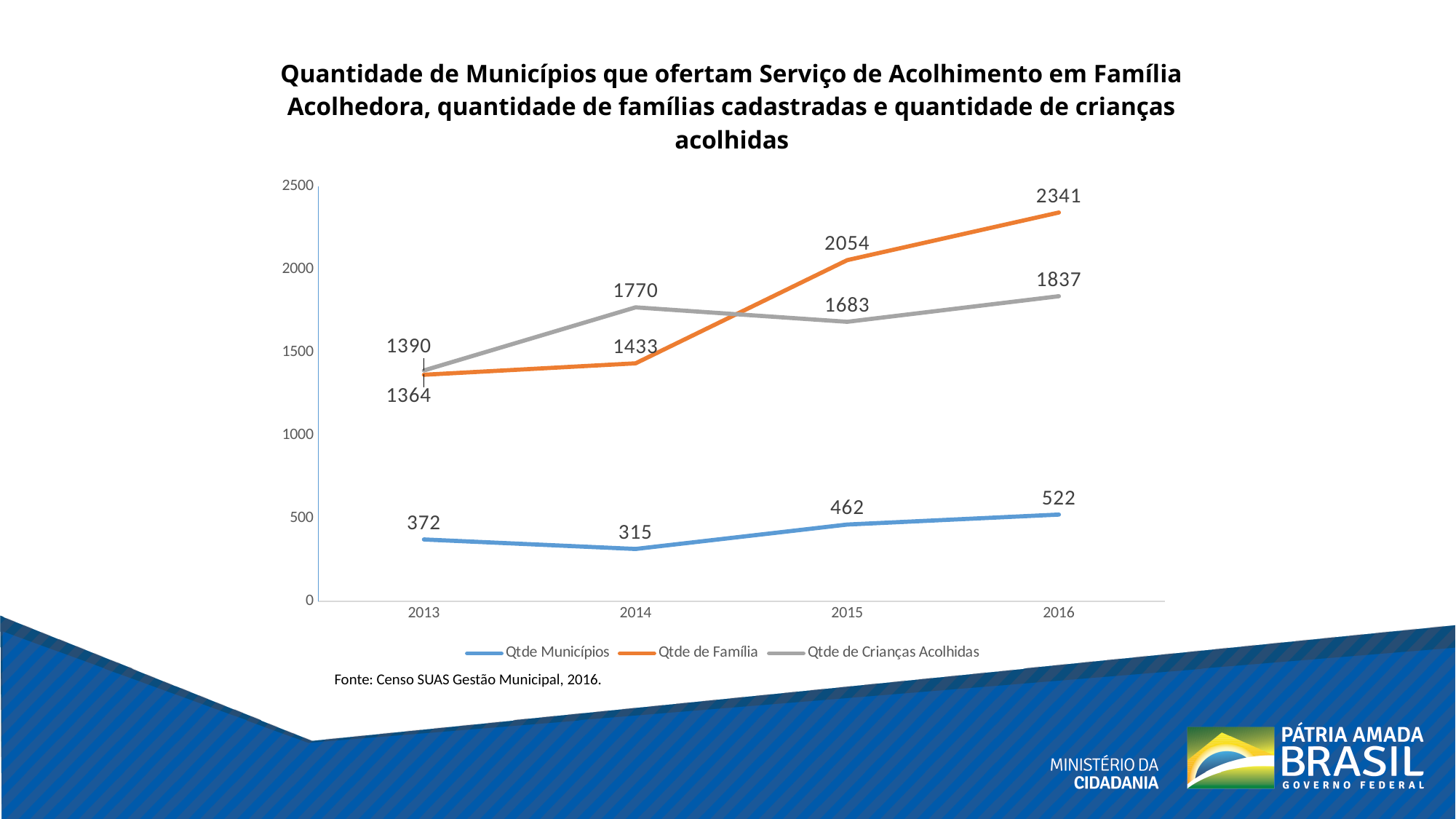
How many series does the legend list? 3 What is the source cited below the chart? Censo SUAS Gestão Municipal, 2016. What is the value of Qtde Municípios in 2014? 315 How many years are shown on the x axis? 4 Does Qtde de Família rise or fall from 2013 to 2016? rise What is the value of Qtde de Crianças Acolhidas in 2015? 1683 In which year is Qtde Municípios lowest? 2014 Which is larger in 2014: Qtde de Família or Qtde de Crianças Acolhidas? Qtde de Crianças Acolhidas What is the value of Qtde de Família in 2016? 2341 What is the difference between Qtde de Família and Qtde de Crianças Acolhidas in 2016? 504 What kind of chart is shown on the slide? line chart In which year is Qtde de Família highest? 2016